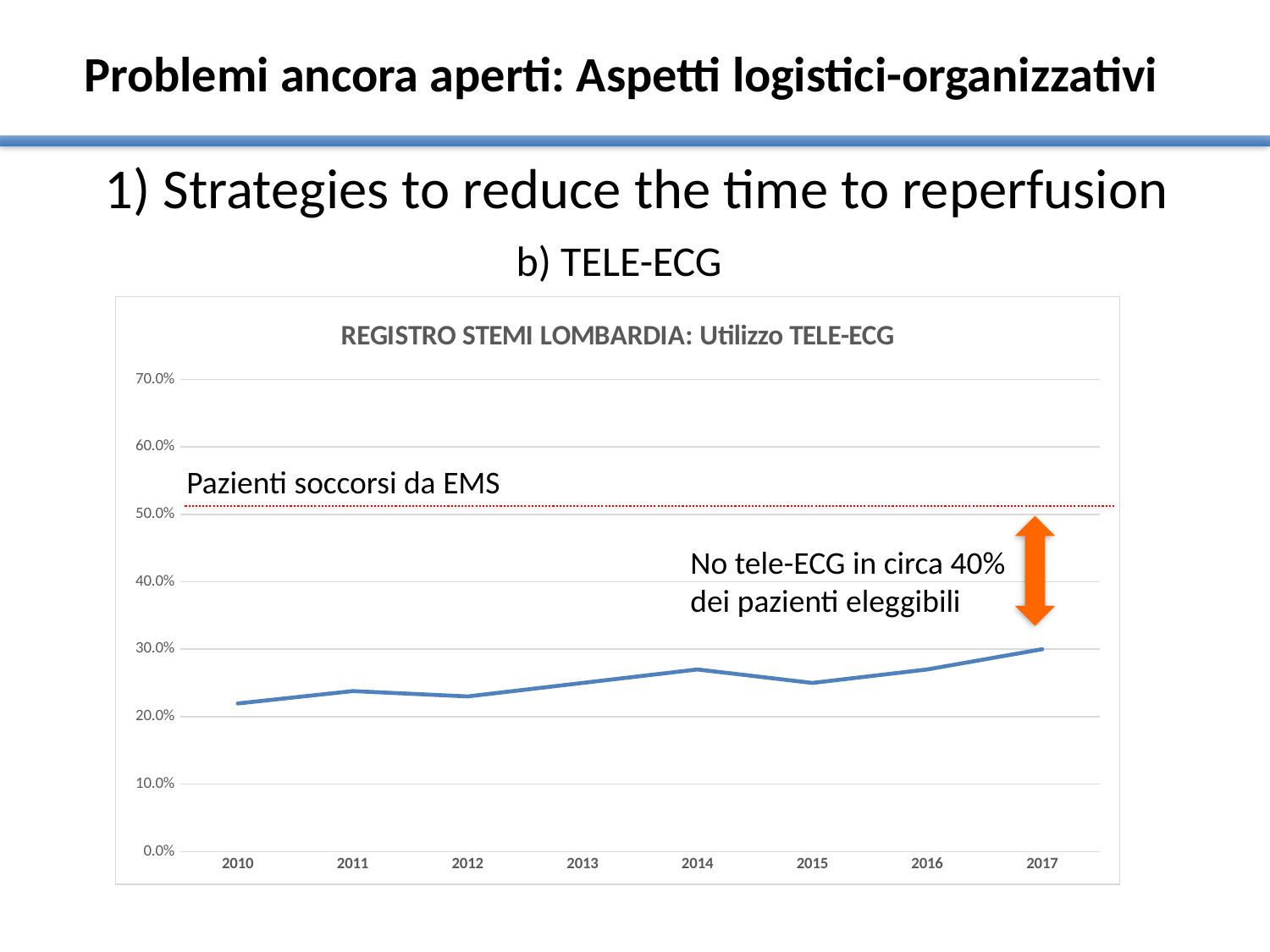
What is the highest value shown on the y axis of the chart? 70.0% Which year has the highest value on the line? 2017 What is the title of the chart? REGISTRO STEMI LOMBARDIA: Utilizzo TELE-ECG How many years are plotted on the x axis of the chart? 8 Is the value for 2014 greater or less than 40.0%? less Which is larger, the value for 2017 or the value for 2010? 2017 What kind of chart is shown on the slide? line chart Is the value for 2010 greater or less than 30.0%? less Which is larger, the value for 2014 or the value for 2012? 2014 What label is given to the dotted red horizontal line on the chart? Pazienti soccorsi da EMS Is the value for 2017 greater or less than 20.0%? greater Overall, does the line rise or fall from 2010 to 2017? rise